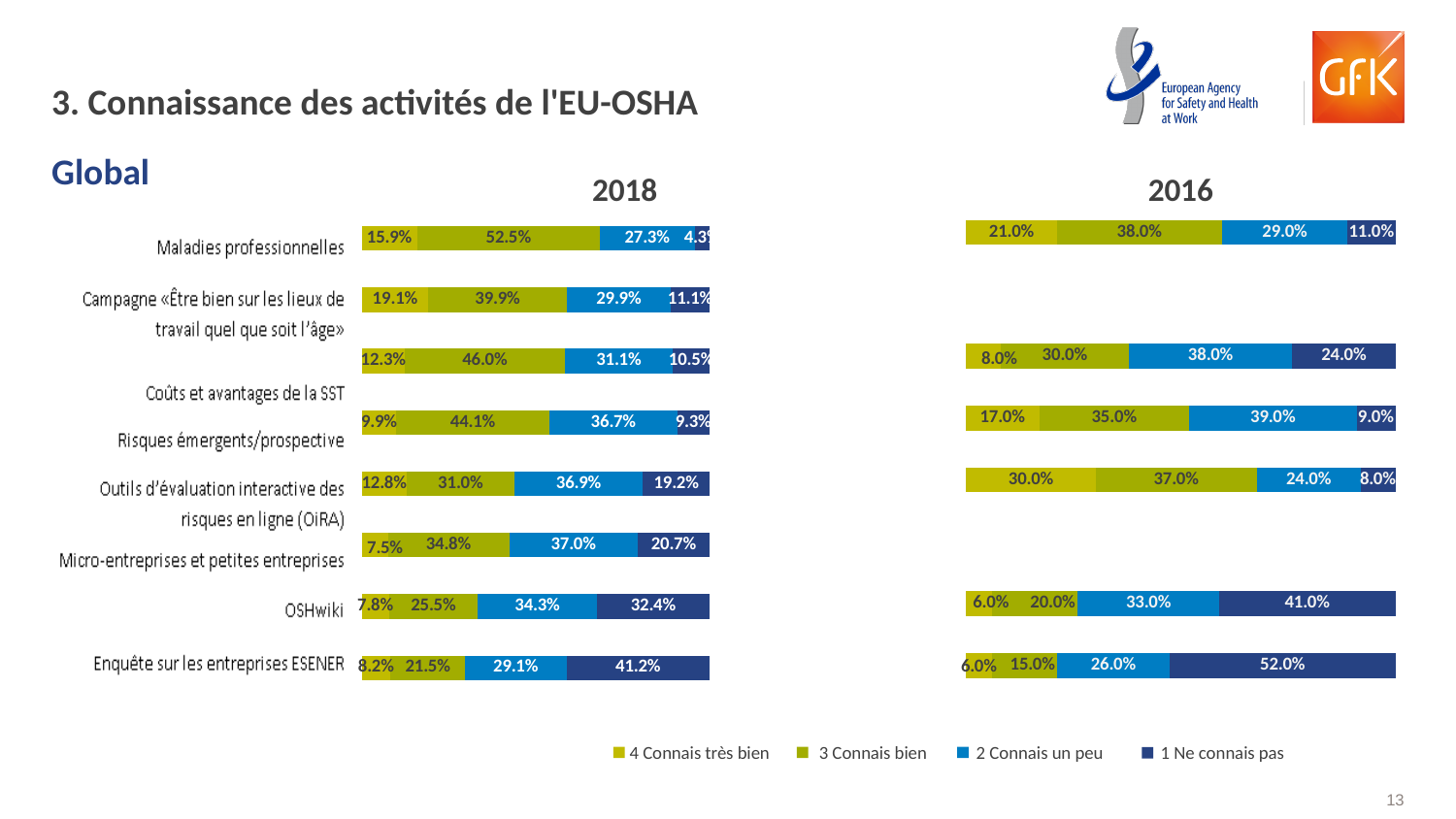
What kind of chart is the 2018 chart? Stacked bar chart In the 2016 chart, what is the "4 Connais très bien" value for the top bar? 21.0% In the 2018 chart, what is the difference between the "2 Connais un peu" values for Risques émergents/prospective and Maladies professionnelles? 9.4% In the 2018 chart, what is the "4 Connais très bien" value for OSHwiki? 7.8% In the 2016 chart, what is the "1 Ne connais pas" value for the bottom bar? 52.0% In the 2018 chart, which category has the highest "1 Ne connais pas" value? Enquête sur les entreprises ESENER In the 2018 chart, which is larger: the "3 Connais bien" value for Coûts et avantages de la SST or for Campagne «Être bien sur les lieux de travail quel que soit l'âge»? Coûts et avantages de la SST In the 2018 chart, what is the "1 Ne connais pas" value for Enquête sur les entreprises ESENER? 41.2% How many series does the legend list? 4 In the 2018 chart, what percentage of respondents answered "3 Connais bien" for Maladies professionnelles? 52.5% How many categories are shown in the 2018 chart? 8 In the 2018 chart, which category has the lowest "4 Connais très bien" value? Micro-entreprises et petites entreprises